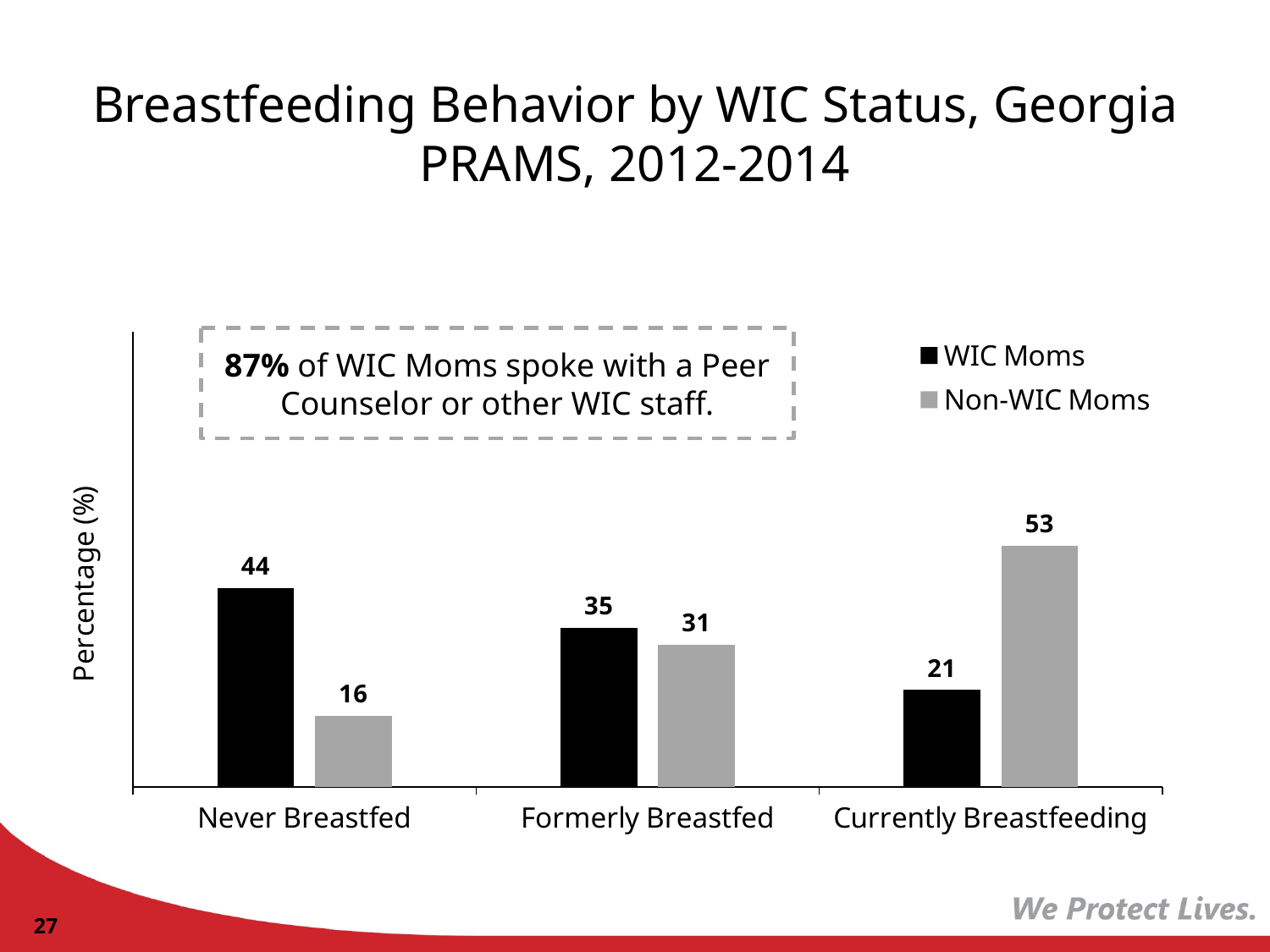
Which category has the highest value for Non-WIC Moms? Currently Breastfeeding What is the value for WIC Moms in the Never Breastfed category? 44 In the Formerly Breastfed category, which series has the larger value, WIC Moms or Non-WIC Moms? WIC Moms What kind of chart is shown on the slide? Bar chart Which category has the lowest value for WIC Moms? Currently Breastfeeding What is the difference between Non-WIC Moms and WIC Moms in the Currently Breastfeeding category? 32 What is the value for Non-WIC Moms in the Currently Breastfeeding category? 53 How many categories are shown on the x axis? 3 What is the difference between WIC Moms and Non-WIC Moms in the Never Breastfed category? 28 What is the value for Non-WIC Moms in the Formerly Breastfed category? 31 What is the label of the y axis? Percentage (%) How many series does the legend list? 2